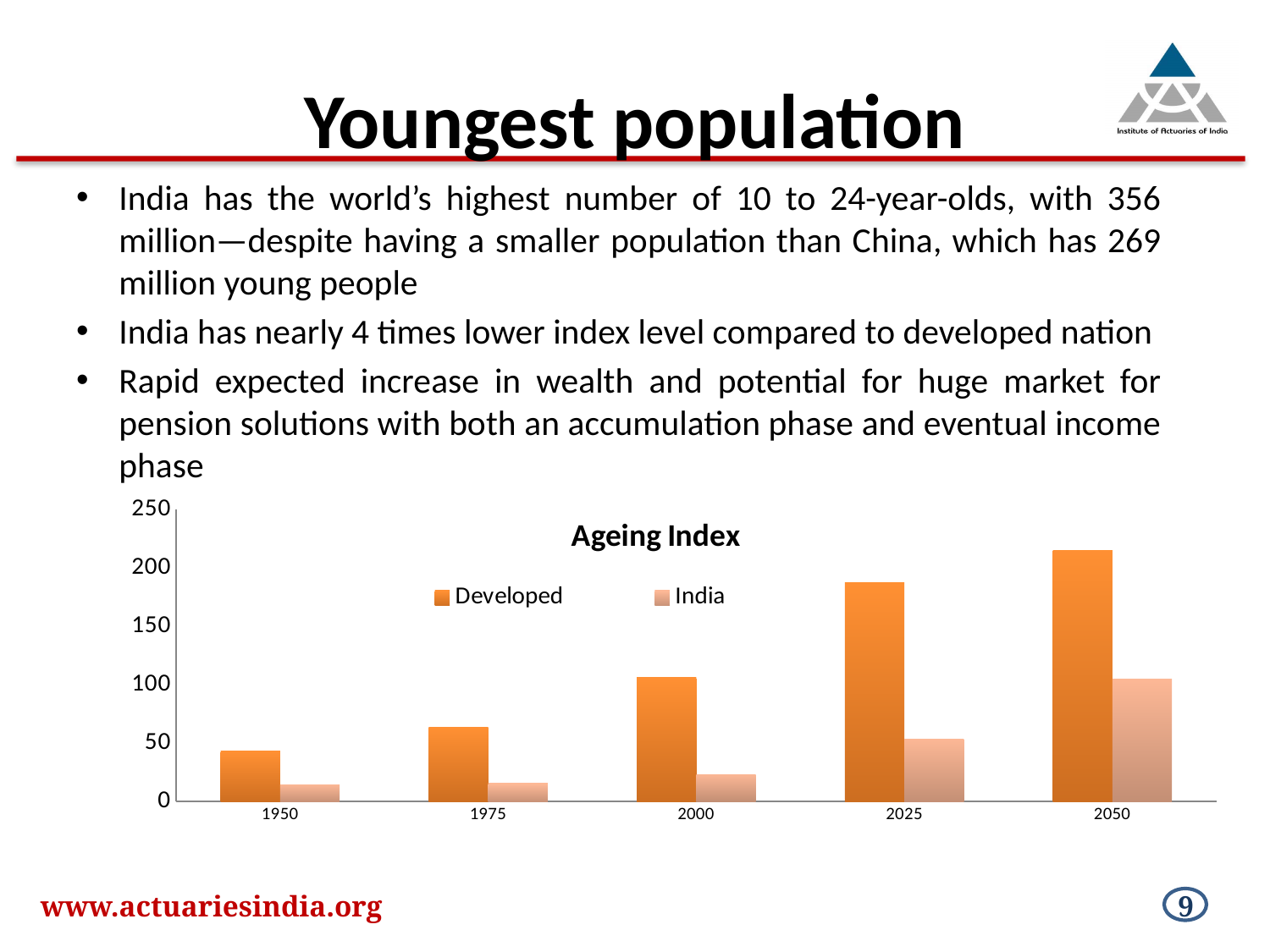
Do the values for the India series rise or fall from 1950 to 2050? rise In which year is the Developed series lowest? 1950 How many series does the chart's legend list? 2 How many years are shown on the x axis of the chart? 5 In 2000, which series has the larger value, Developed or India? Developed In which year is the Developed series highest? 2050 Is the value for India in 2000 greater or less than 50? less What type of chart is shown on the slide? bar chart What is the title of the chart? Ageing Index In which year is the India series highest? 2050 Is the value for Developed in 1950 greater or less than 50? less Is the value for Developed in 2025 greater or less than 150? greater